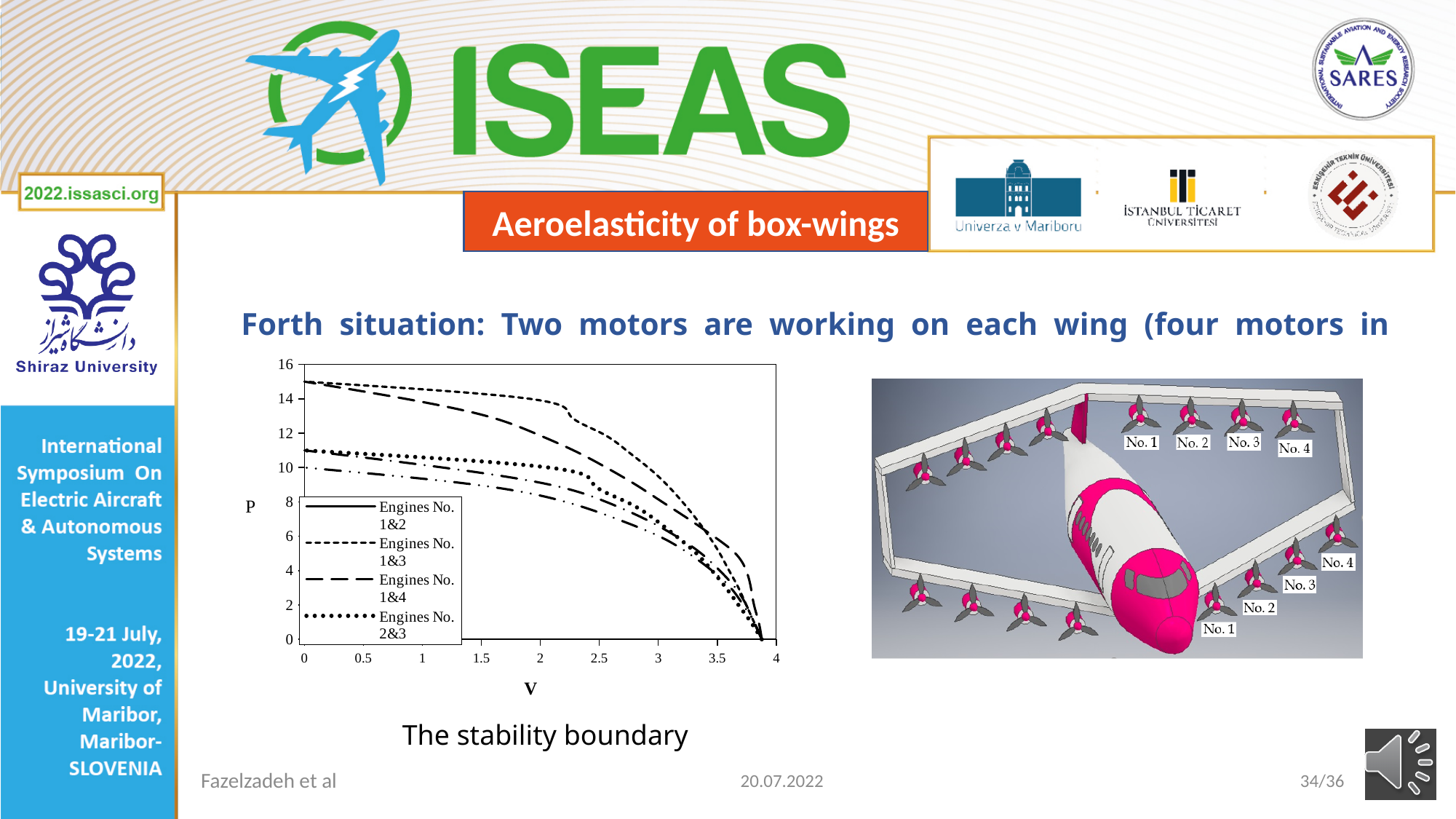
What kind of chart is shown on the slide? line chart Is the value of P for Engines No. 1&3 at V = 3 greater or less than 10? less How many series does the legend of the chart list? 4 Do the values of P rise or fall as V increases along the x axis? fall Is the value of P for Engines No. 2&3 at V = 0 greater or less than 10? greater Is the value of P for Engines No. 1&3 at V = 0 greater or less than 14? greater What caption is written below the chart? The stability boundary What label is shown on the vertical axis of the chart? P